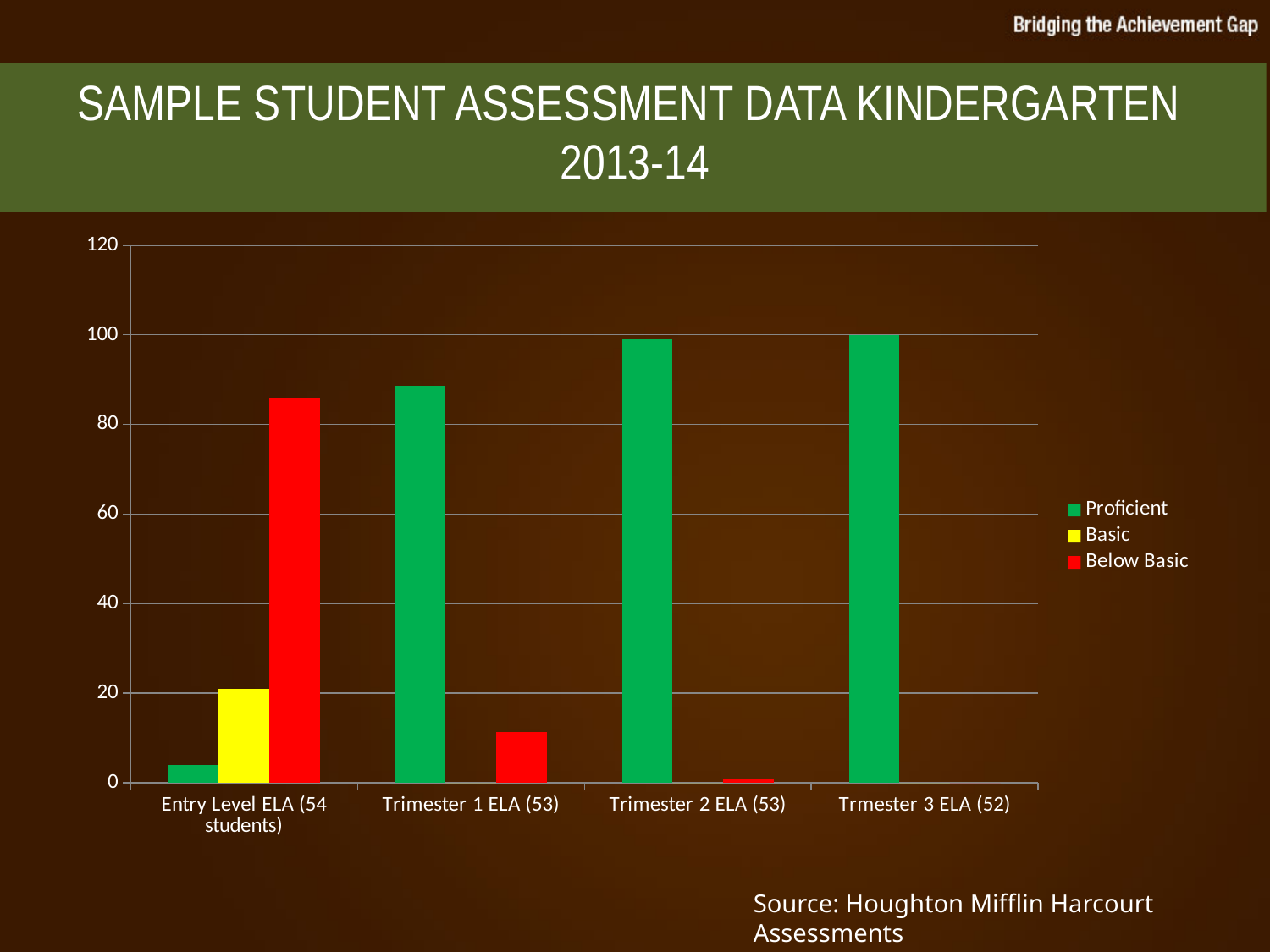
Is the Below Basic value for Entry Level ELA (54 students) greater or less than 80? greater How many series does the legend list? 3 Which category has the highest Proficient value? Trmester 3 ELA (52) Which category has the highest Below Basic value? Entry Level ELA (54 students) Do the Proficient values rise or fall from Entry Level ELA to Trmester 3 ELA? rise What kind of chart is shown on the slide? bar chart What colour represents the Below Basic series in the legend? red Which category has the lowest Proficient value? Entry Level ELA (54 students) Is the Basic value for Entry Level ELA (54 students) greater or less than 40? less Is the Proficient value for Trimester 1 ELA (53) greater or less than 80? greater Which is larger for Entry Level ELA (54 students): the Basic value or the Below Basic value? Below Basic How many assessment categories are shown along the x axis? 4